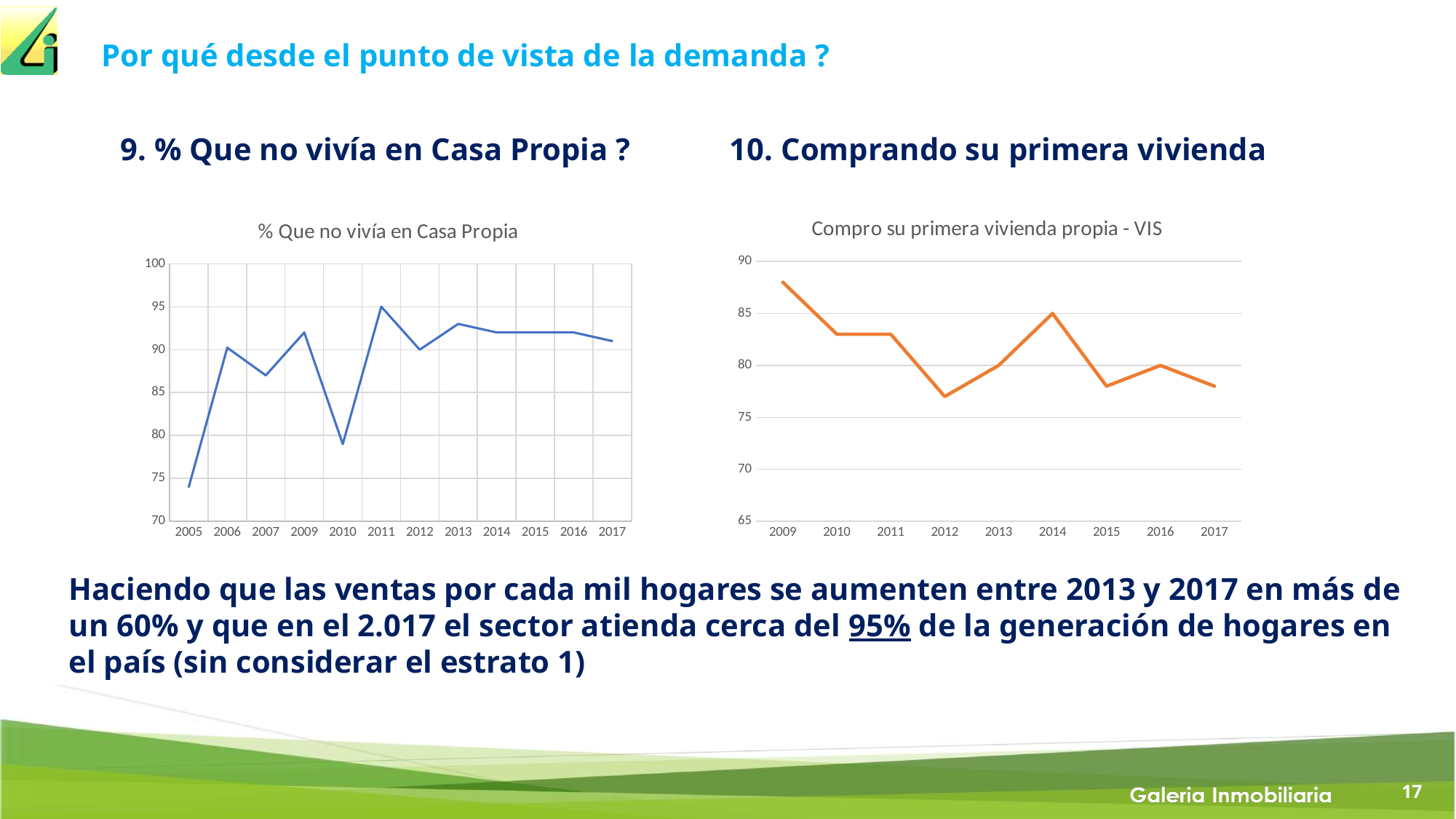
In the '% Que no vivía en Casa Propia' chart, which year has the highest value? 2011 What colour is the line in the 'Compro su primera vivienda propia - VIS' chart? orange In the '% Que no vivía en Casa Propia' chart, which year has the lowest value? 2005 In the '% Que no vivía en Casa Propia' chart, is the value for 2005 greater or less than 75? less In the 'Compro su primera vivienda propia - VIS' chart, which year has the highest value? 2009 In the '% Que no vivía en Casa Propia' chart, how many years are shown on the x axis? 12 In the '% Que no vivía en Casa Propia' chart, which is larger, the value for 2007 or the value for 2009? 2009 In the '% Que no vivía en Casa Propia' chart, is the value for 2010 greater or less than 80? less In the 'Compro su primera vivienda propia - VIS' chart, which year has the lowest value? 2012 In the 'Compro su primera vivienda propia - VIS' chart, is the value for 2009 greater or less than 85? greater What kind of chart is the '% Que no vivía en Casa Propia' chart on the left? line chart In the 'Compro su primera vivienda propia - VIS' chart, how many years are shown on the x axis? 9